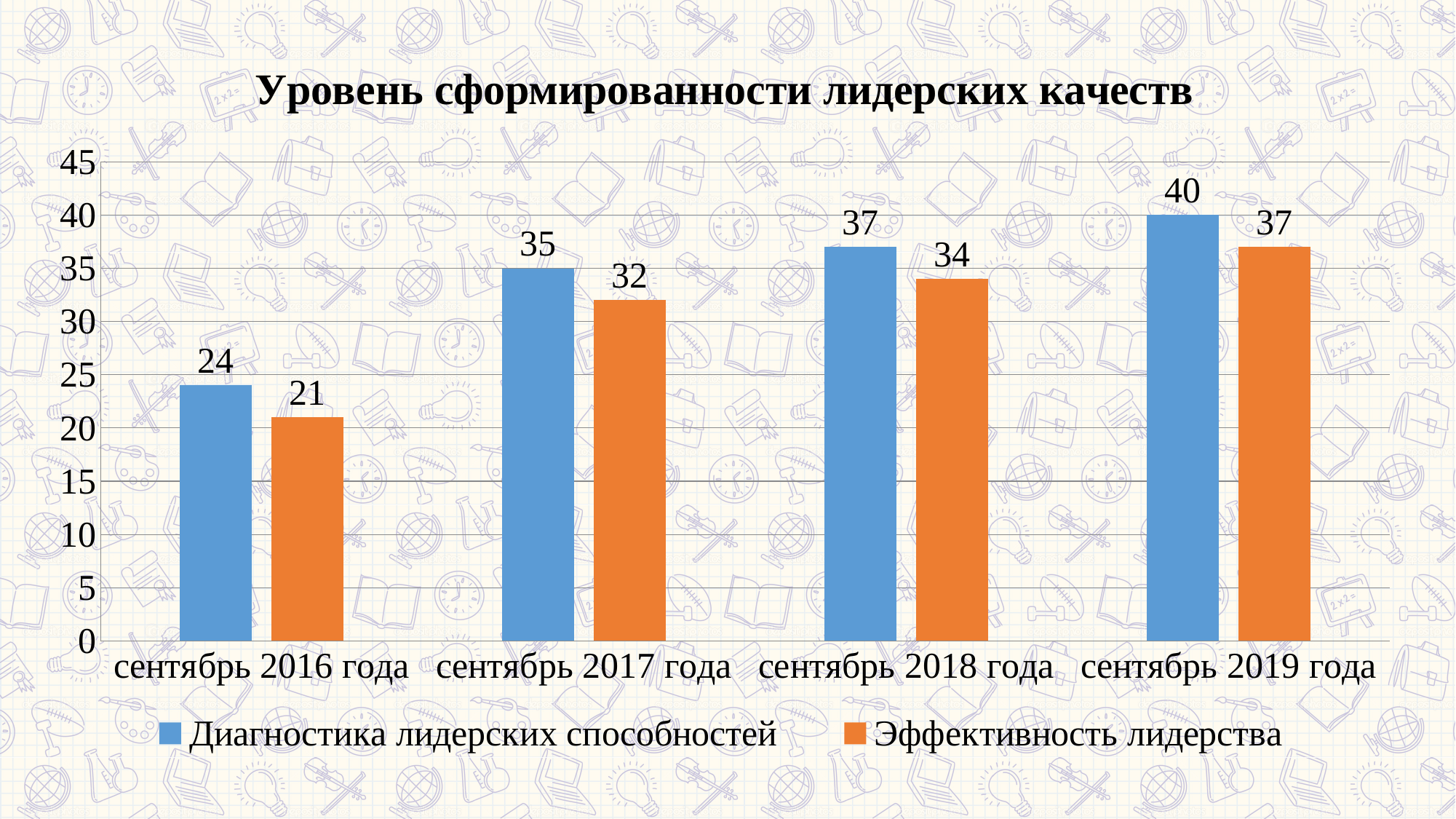
What is the title of the chart? Уровень сформированности лидерских качеств Which category has the lowest value for Эффективность лидерства? сентябрь 2016 года How many categories are shown on the x axis? 4 How many series does the legend list? 2 What is the difference between Диагностика лидерских способностей and Эффективность лидерства for сентябрь 2017 года? 3 What is the value of Эффективность лидерства for сентябрь 2018 года? 34 What is the value of Эффективность лидерства for сентябрь 2019 года? 37 What is the value of Диагностика лидерских способностей for сентябрь 2016 года? 24 Which category has the highest value for Диагностика лидерских способностей? сентябрь 2019 года Do the values for Эффективность лидерства rise or fall from сентябрь 2016 года to сентябрь 2019 года? rise What kind of chart is shown on the slide? bar chart Which is larger for сентябрь 2018 года: Диагностика лидерских способностей or Эффективность лидерства? Диагностика лидерских способностей